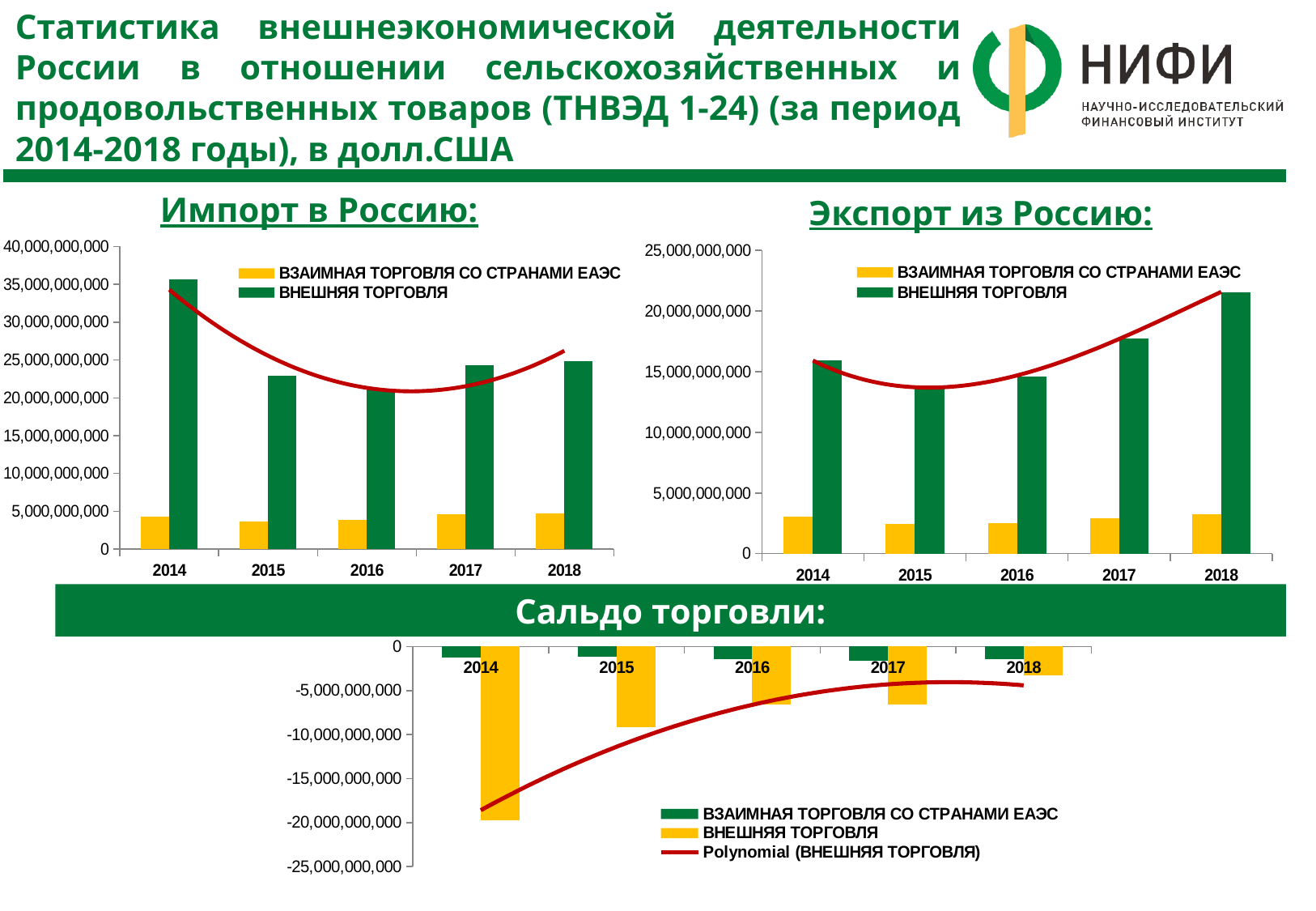
In the 'Экспорт из Россию' chart, which year has the lowest value for ВНЕШНЯЯ ТОРГОВЛЯ? 2015 How many series does the legend of the 'Экспорт из Россию' chart list? 2 How many entries does the legend of the 'Сальдо торговли' chart list? 3 In the 'Импорт в Россию' chart, which year has the lowest value for ВНЕШНЯЯ ТОРГОВЛЯ? 2016 In the 'Импорт в Россию' chart, is the ВНЕШНЯЯ ТОРГОВЛЯ value for 2014 greater or less than 30,000,000,000? greater In the 'Сальдо торговли' chart, is the ВНЕШНЯЯ ТОРГОВЛЯ value for 2014 greater or less than -15,000,000,000? less In the 'Импорт в Россию' chart, which year has the highest value for ВНЕШНЯЯ ТОРГОВЛЯ? 2014 In the 'Экспорт из Россию' chart, which is larger for ВНЕШНЯЯ ТОРГОВЛЯ: 2016 or 2017? 2017 What kind of chart is the 'Импорт в Россию' chart? bar chart In the 'Экспорт из Россию' chart, which year has the highest value for ВНЕШНЯЯ ТОРГОВЛЯ? 2018 In the 'Импорт в Россию' chart, how many years are shown on the x axis? 5 In the 'Экспорт из Россию' chart, is the ВНЕШНЯЯ ТОРГОВЛЯ value for 2018 greater or less than 20,000,000,000? greater